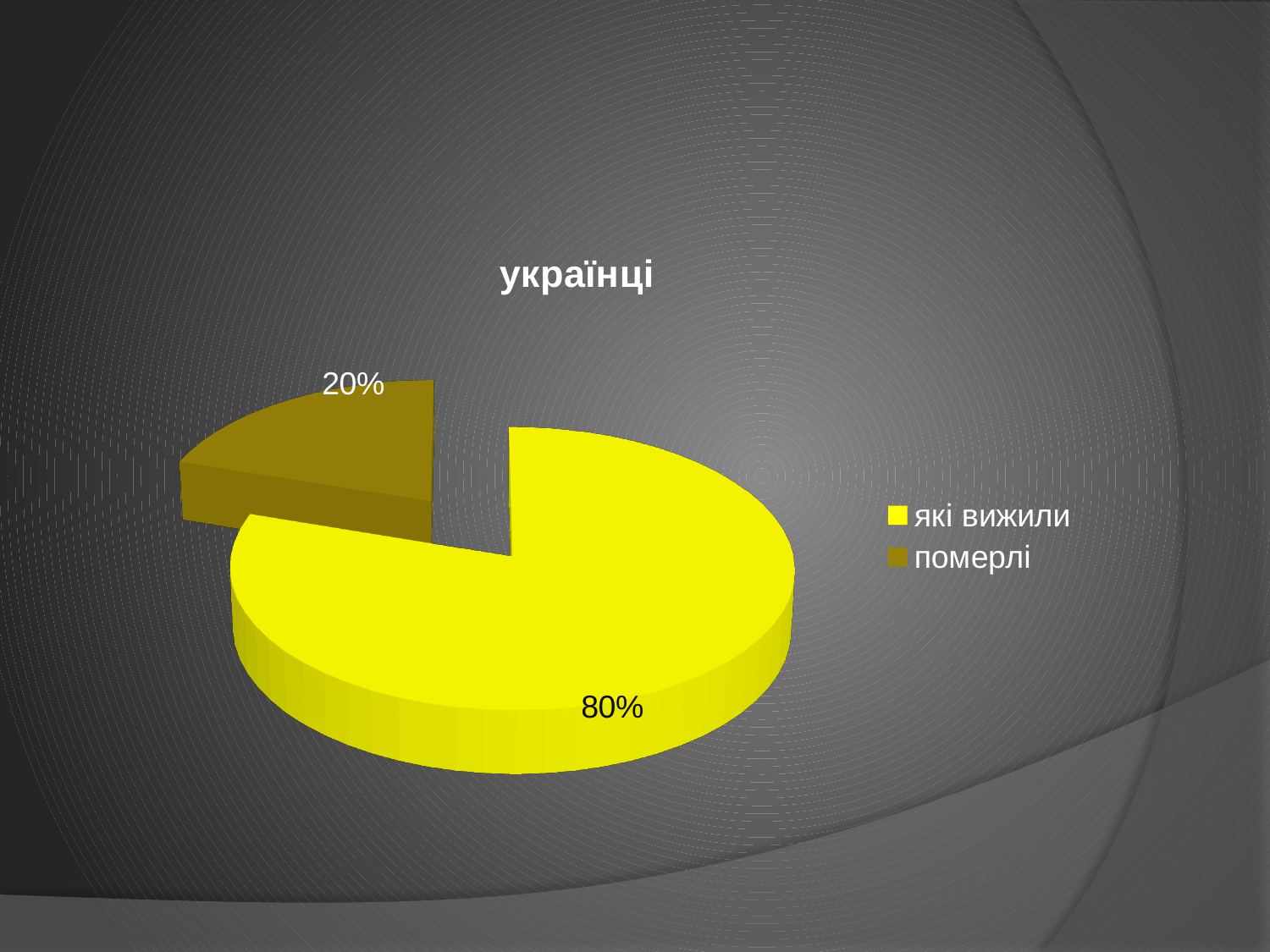
Which slice is the largest in the pie chart? які вижили What share of the pie does the slice 'які вижили' represent? 80% How many entries does the legend list? 2 Which is larger, the share for 'які вижили' or the share for 'померлі'? які вижили What is the difference between the shares of 'які вижили' and 'померлі'? 60% What share of the pie does the slice 'померлі' represent? 20% What is the title of the chart? українці What colour is the slice for 'померлі'? dark olive/brown Which slice is the smallest in the pie chart? померлі What kind of chart is shown on the slide? pie chart How many slices does the pie chart have? 2